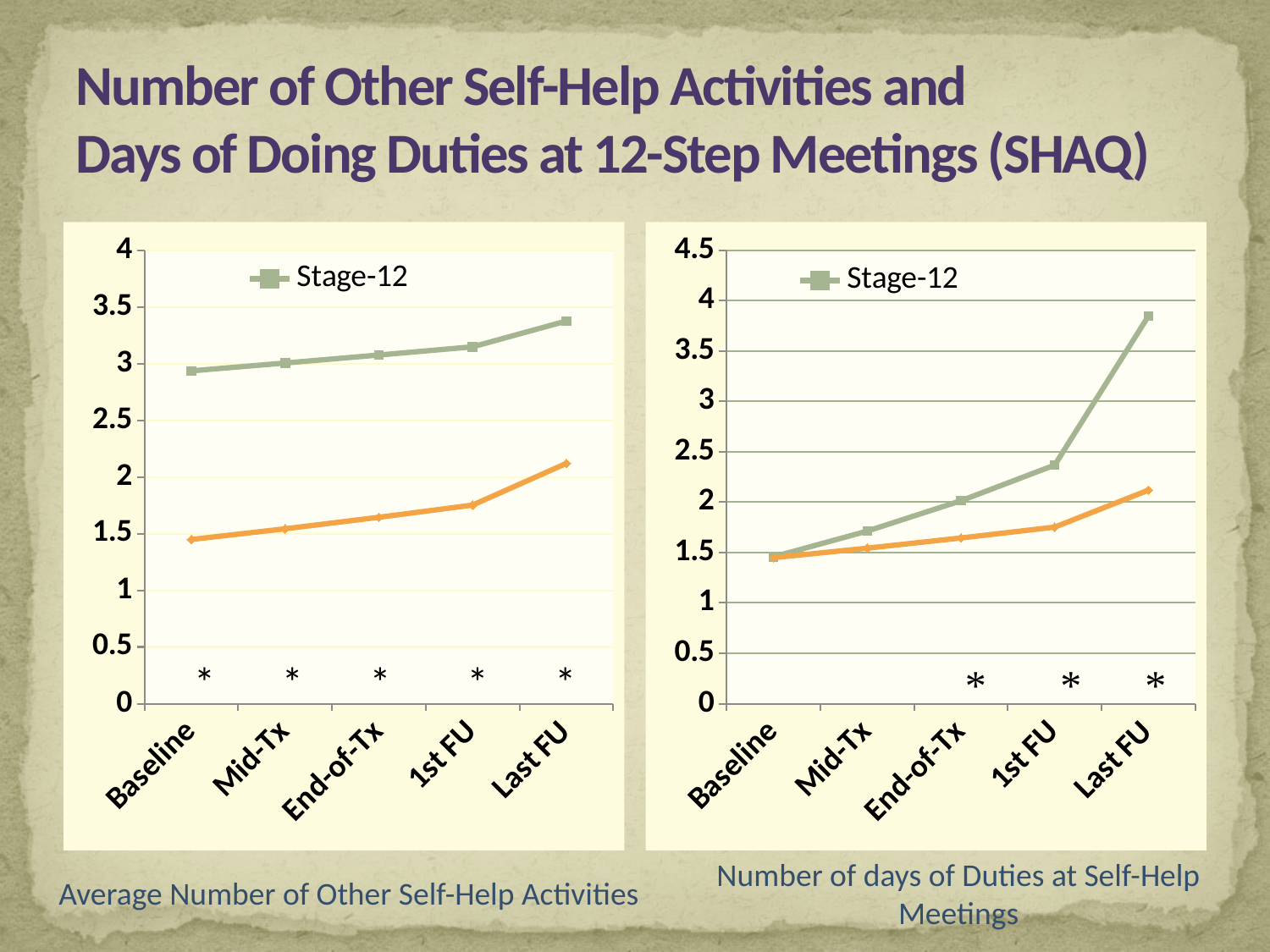
How many categories are shown on the x axis of the right chart, Number of days of Duties at Self-Help Meetings? 5 In the right chart, at which category is the Stage-12 value highest? Last FU In the left chart, at which category is the Stage-12 value highest? Last FU In the left chart, at which category is the Stage-12 value lowest? Baseline In the left chart, is the Stage-12 value at Baseline greater or less than 2.5? greater What kind of chart is the left chart, Average Number of Other Self-Help Activities? line chart In the right chart, is the Stage-12 value at Last FU greater or less than 3.5? greater In the right chart, is the Stage-12 value at End-of-Tx greater or less than 2.5? less How many series does the legend of the left chart list? 1 In the right chart, Number of days of Duties at Self-Help Meetings, does the Stage-12 line rise or fall from Baseline to Last FU? rise What is the name of the series listed in the legend of the right chart? Stage-12 In the left chart, Average Number of Other Self-Help Activities, does the Stage-12 line rise or fall from Baseline to Last FU? rise